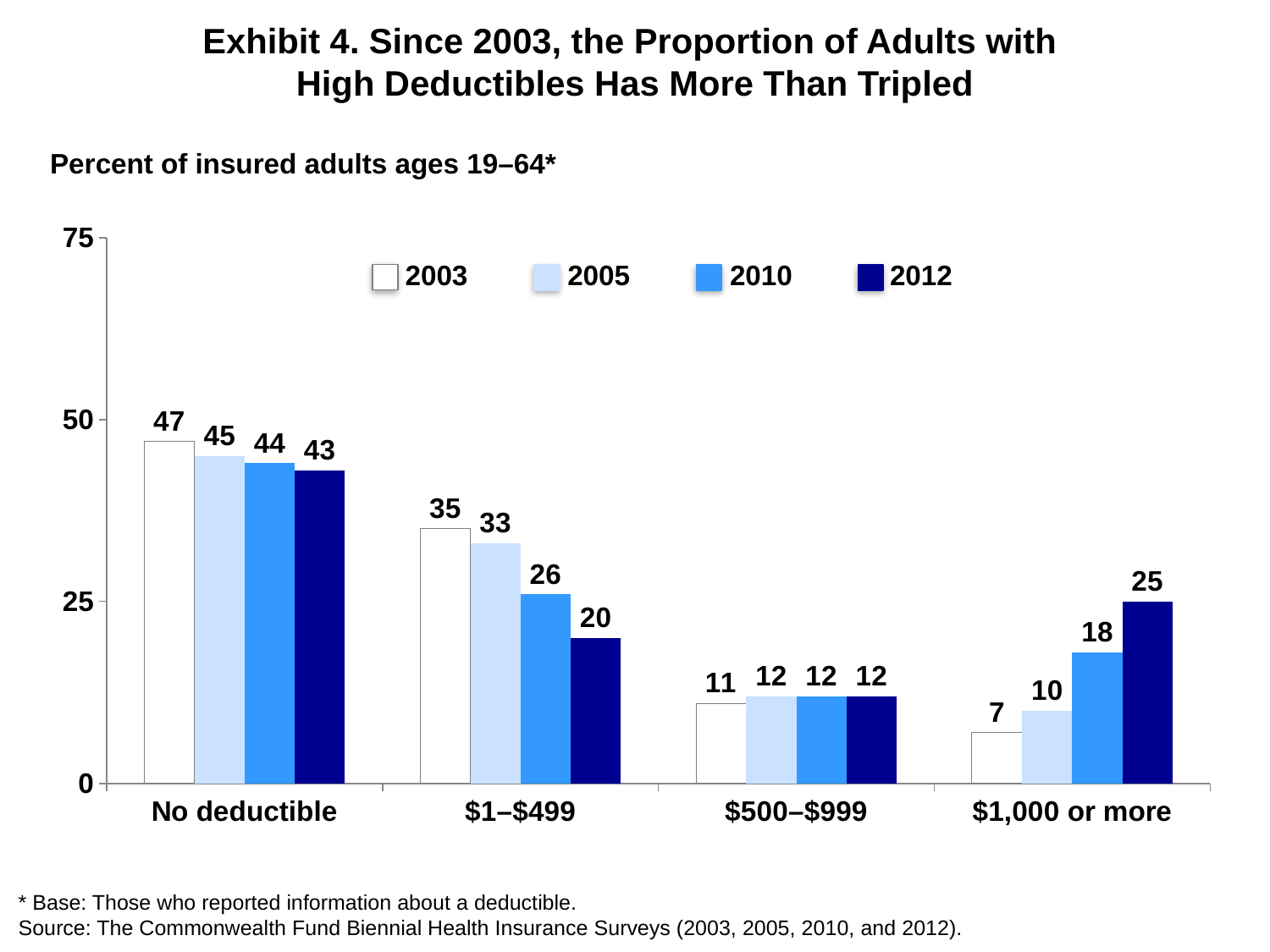
Which is larger in the "$1–$499" category: the 2005 value or the 2010 value? 2005 Do the values for the "$1,000 or more" category rise or fall from 2003 to 2012? Rise What is the value for 2003 in the "No deductible" category? 47 What is the difference between the 2003 and 2012 values in the "$1–$499" category? 15 How many deductible categories are shown on the x axis? 4 What is the value for 2012 in the "$1,000 or more" category? 25 Which category has the lowest value for 2003? $1,000 or more What kind of chart is shown on the slide? Bar chart Which category has the highest value for 2003? No deductible What is the value for 2010 in the "$1–$499" category? 26 How many series does the legend list? 4 What is the difference between the 2012 and 2003 values in the "$1,000 or more" category? 18